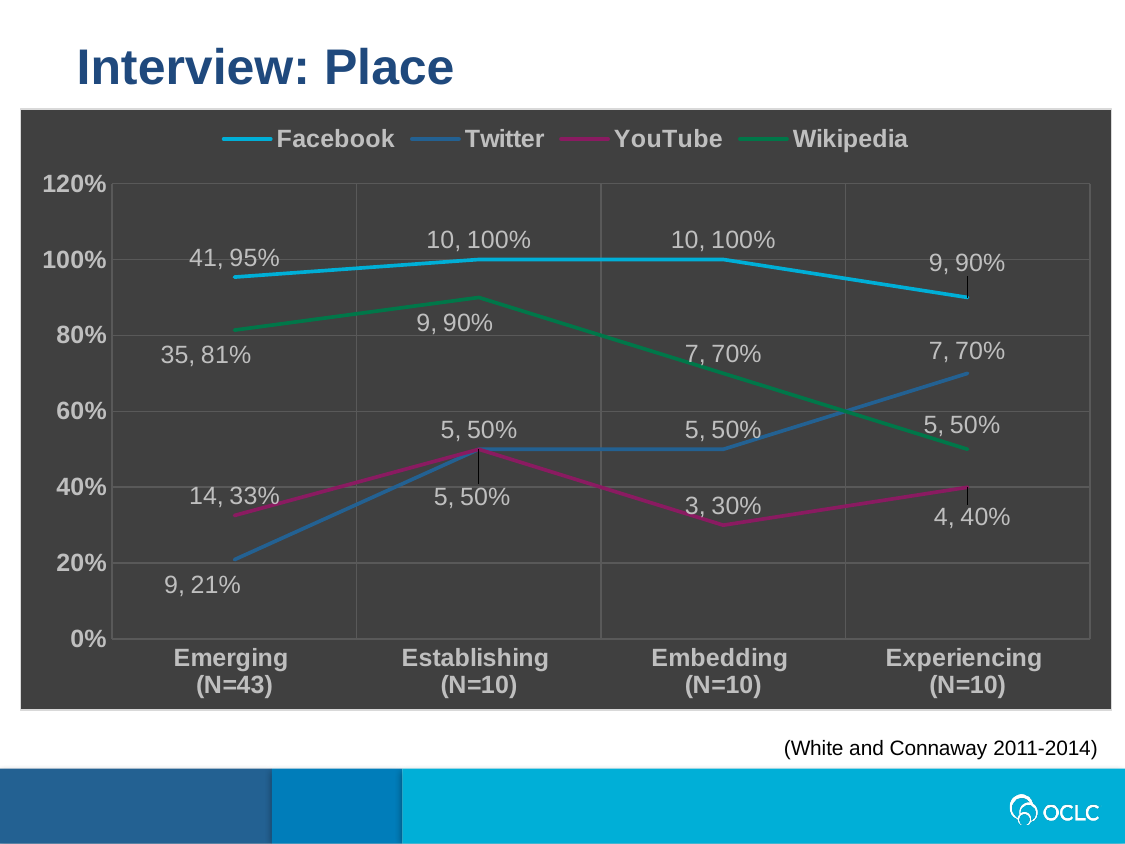
What is the percentage value for YouTube at Embedding (N=10)? 30% What is the difference in percentage points between Facebook and Wikipedia at Embedding (N=10)? 30 What is the percentage value for Twitter at Emerging (N=43)? 21% Which is larger at Experiencing (N=10): the value for Twitter or the value for Wikipedia? Twitter How many categories are shown on the x axis? 4 What kind of chart is shown on the slide? Line chart What is the percentage value for Wikipedia at Establishing (N=10)? 90% Does the Wikipedia line rise or fall from Establishing (N=10) to Experiencing (N=10)? Fall How many series does the legend list? 4 What is the percentage value for Facebook at Emerging (N=43)? 95% Which series has the highest value at Experiencing (N=10)? Facebook Which series has the lowest value at Emerging (N=43)? Twitter